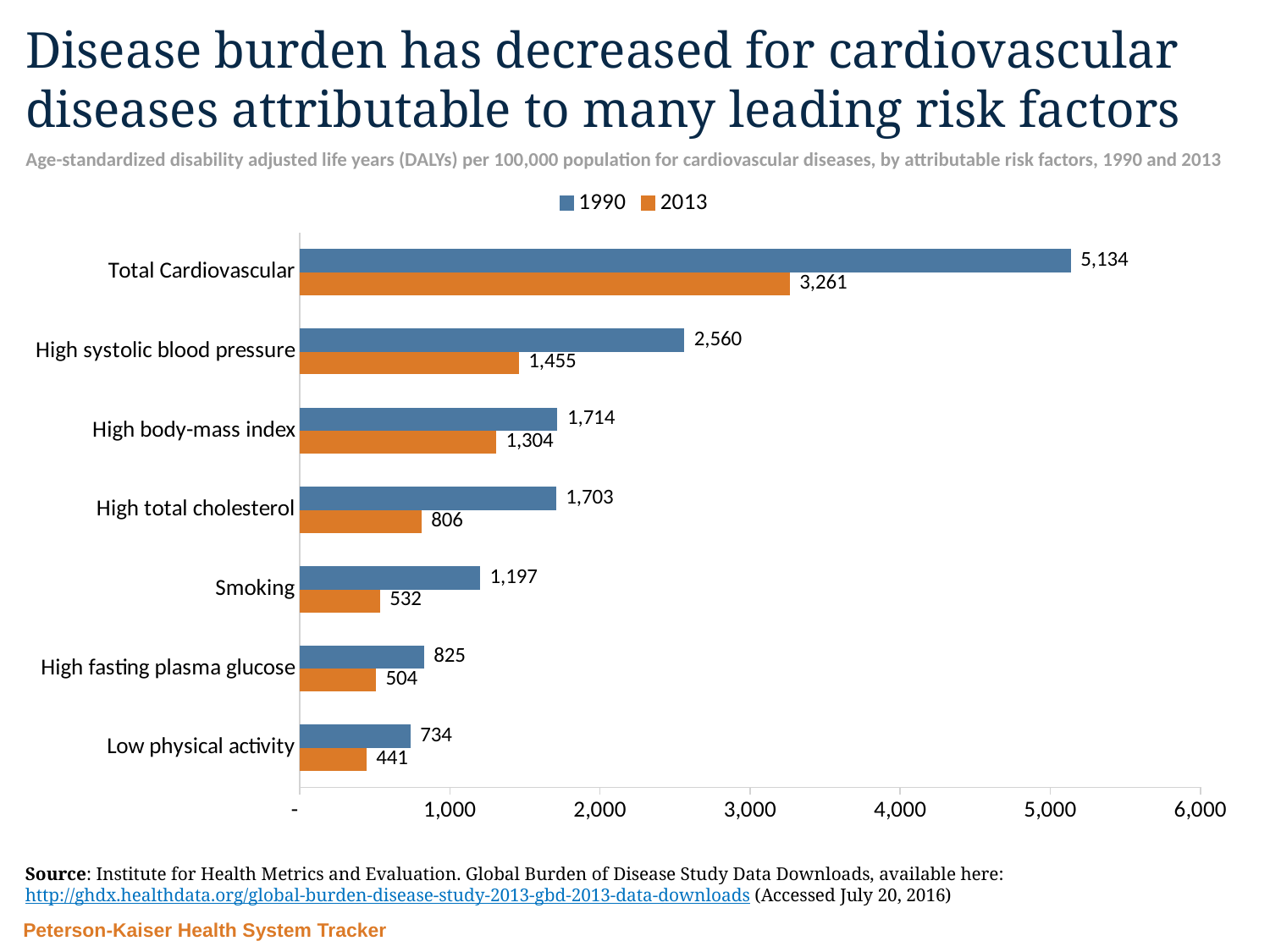
Which category has the lowest 2013 value? Low physical activity What kind of chart is shown on the slide? Bar chart What is the difference between the 1990 and 2013 values for High total cholesterol? 897 What is the 2013 value for Total Cardiovascular? 3,261 Which category has the highest 1990 value? Total Cardiovascular What is the 2013 value for Smoking? 532 How many categories are shown on the chart? 7 Which is larger: the 2013 value for High body-mass index or the 2013 value for High total cholesterol? High body-mass index Which colour represents the 2013 series in the legend? Orange How many series does the legend list? 2 Is the 1990 value for Smoking greater or less than 1,000? greater What is the 1990 value for High systolic blood pressure? 2,560